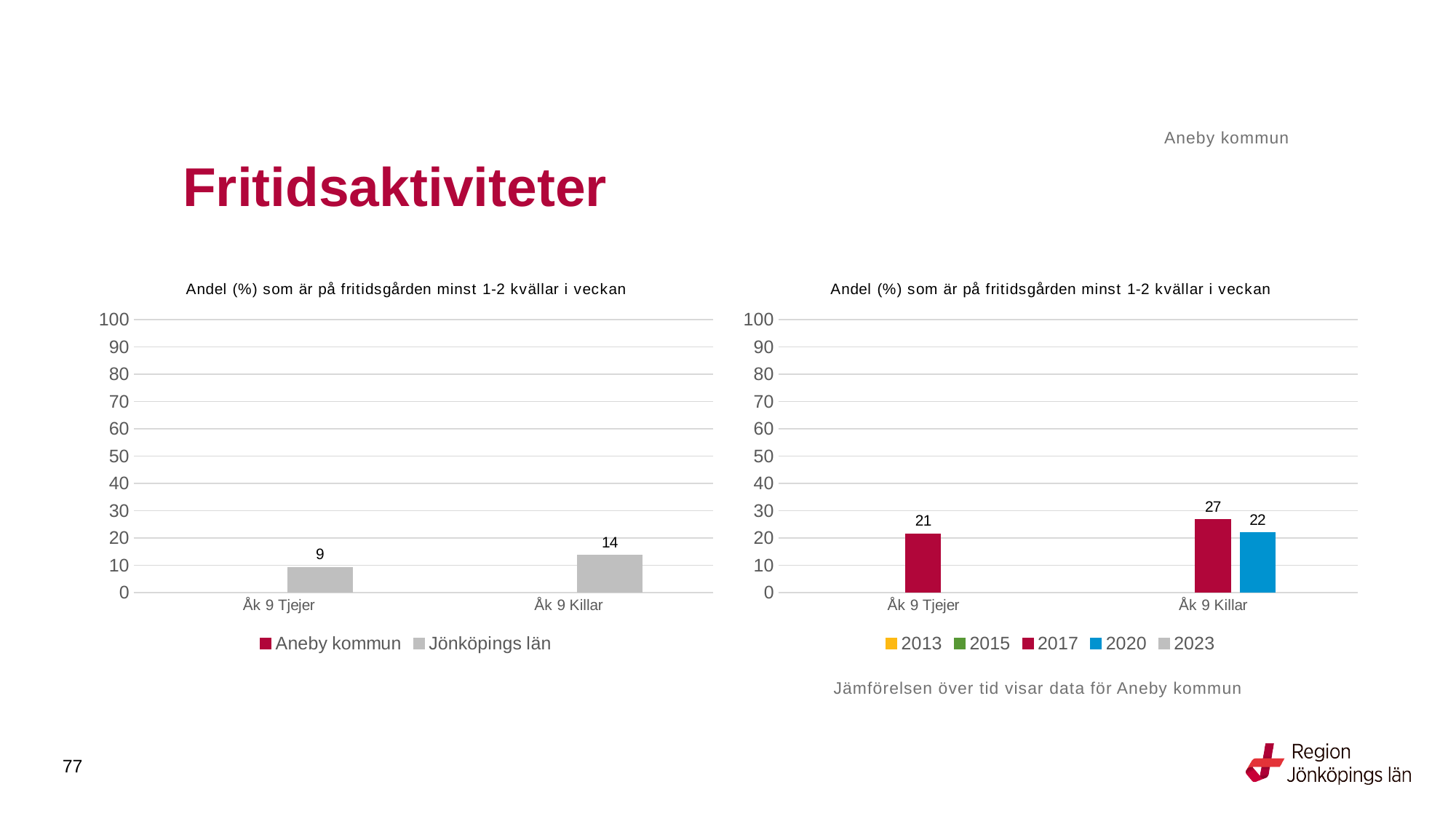
In the right chart, what is the value for 2020 for Åk 9 Killar? 22 In the right chart, is the 2017 value for Åk 9 Killar greater or less than 30? less In the left chart, how many series does the legend list? 2 In the left chart, what is the value for Jönköpings län for Åk 9 Tjejer? 9 What kind of chart is the right chart? Bar chart In the right chart, what is the value for 2017 for Åk 9 Killar? 27 In the right chart, how many series does the legend list? 5 In the right chart, what is the value for 2017 for Åk 9 Tjejer? 21 In the right chart, what is the difference between the 2017 and 2020 values for Åk 9 Killar? 5 In the left chart, what is the value for Jönköpings län for Åk 9 Killar? 14 In the left chart, which category has the higher Jönköpings län value, Åk 9 Tjejer or Åk 9 Killar? Åk 9 Killar In the left chart, what is the difference between the Jönköpings län values for Åk 9 Killar and Åk 9 Tjejer? 5